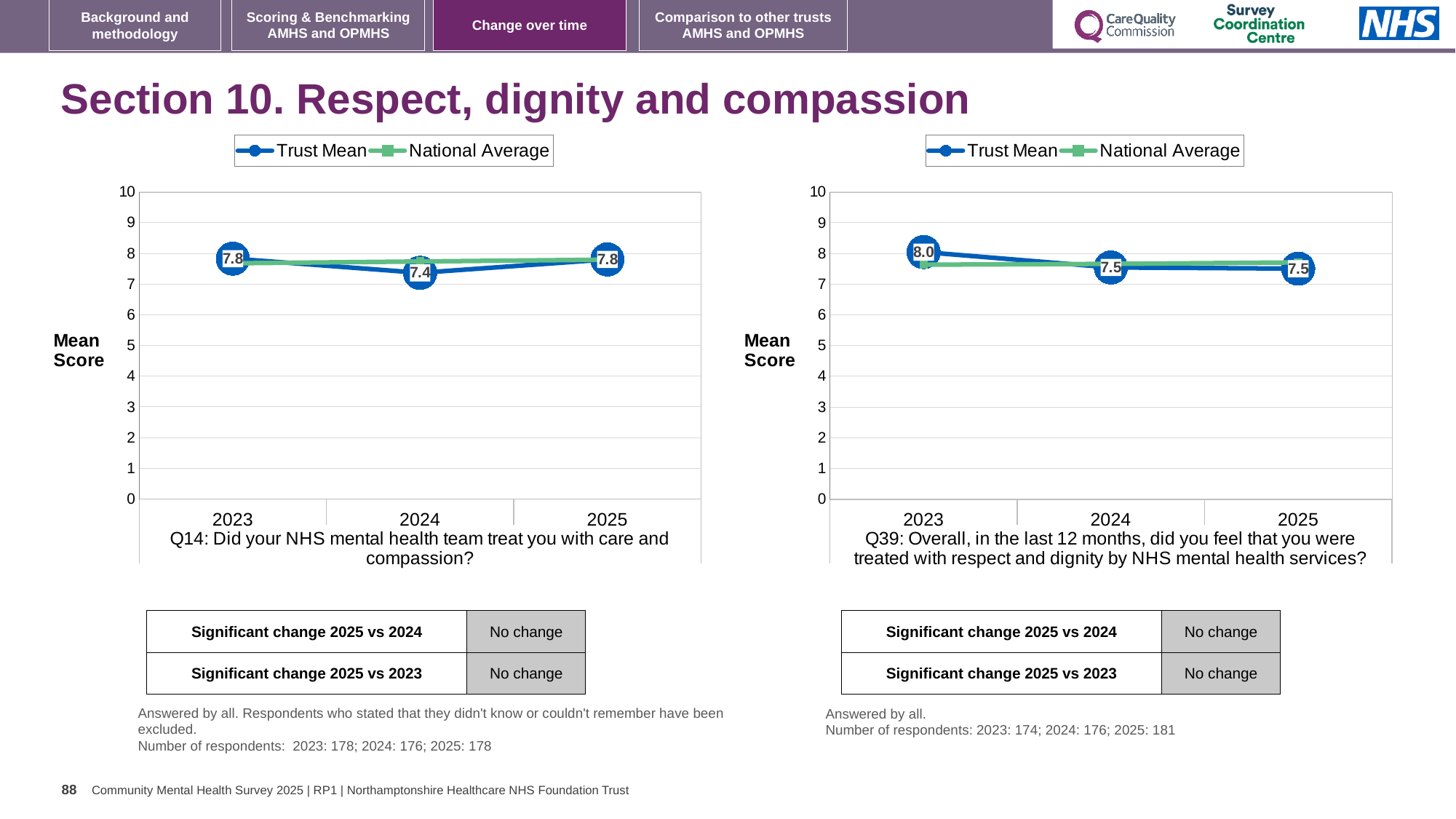
How many series does the legend of the Q39 chart (right) list? 2 How many years are plotted on the x axis of the Q14 chart (left)? 3 On the Q14 chart (left), what is the Trust Mean score for 2025? 7.8 On the Q39 chart (right), what is the difference between the Trust Mean scores for 2023 and 2025? 0.5 What type of chart is the Q14 chart (left)? Line chart On the Q14 chart (left), what is the Trust Mean score for 2024? 7.4 On the Q39 chart (right), which year has the highest Trust Mean score? 2023 On the Q39 chart (right), what is the Trust Mean score for 2023? 8.0 On the Q14 chart (left), which year has the lowest Trust Mean score? 2024 On the Q14 chart (left), what is the difference between the Trust Mean scores for 2025 and 2024? 0.4 On the Q39 chart (right), is the Trust Mean score for 2023 greater or less than 7? greater On the Q39 chart (right), what is the Trust Mean score for 2025? 7.5